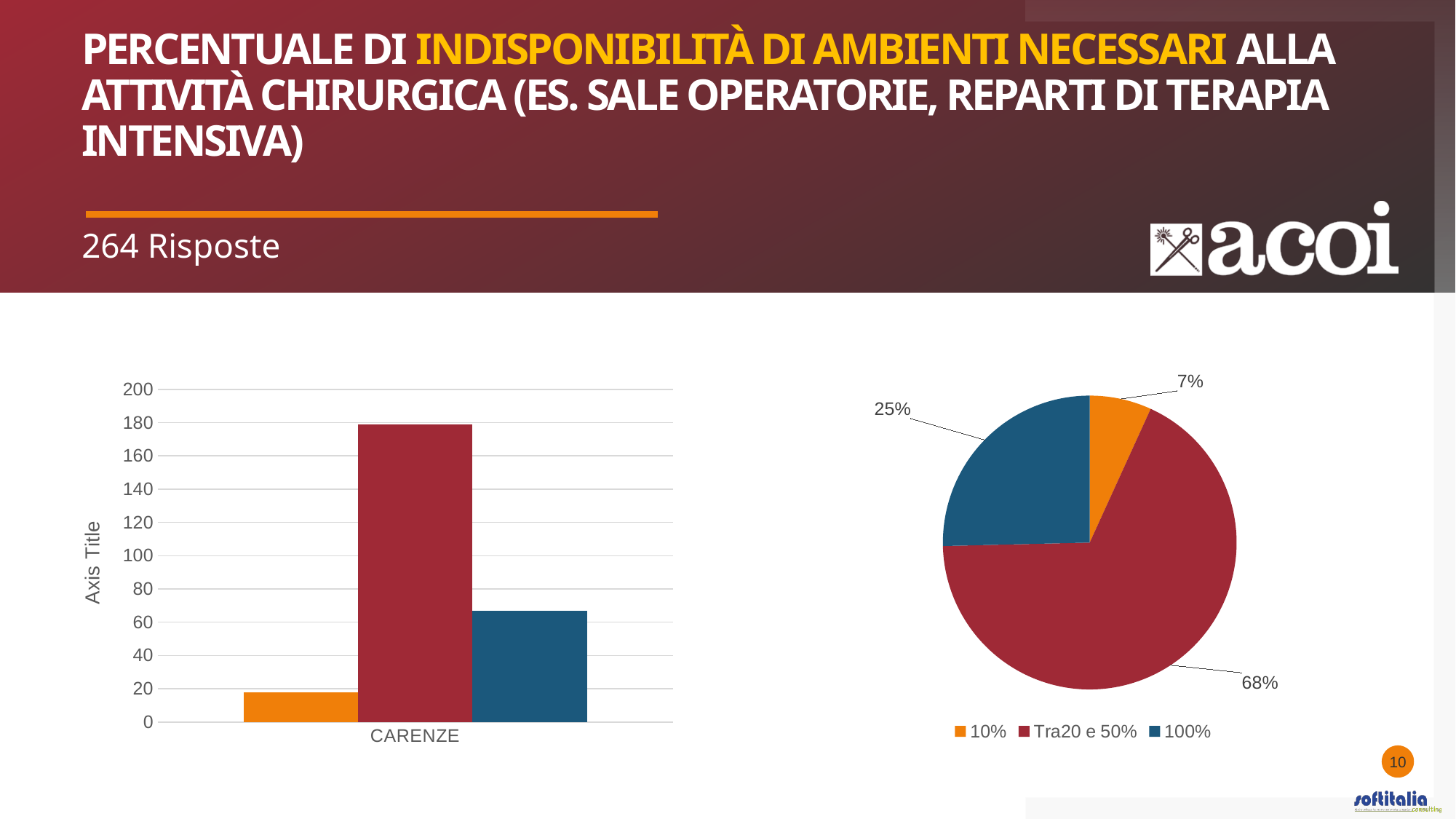
In the bar chart on the left, is the value of the orange (left) bar greater or less than 20? less In the pie chart on the right, what share is shown for the 'Tra20 e 50%' slice? 68% What kind of chart is the chart on the left of the slide? Bar chart In the bar chart on the left, what is the category label shown on the x axis? CARENZE In the pie chart on the right, what share is shown for the '100%' slice? 25% In the pie chart on the right, which legend category has the smallest slice? 10% How many entries does the legend of the pie chart on the right list? 3 In the pie chart on the right, what share is shown for the '10%' slice? 7% In the bar chart on the left, is the value of the red (middle) bar greater or less than 160? greater In the bar chart on the left, which bar is the tallest? The red (middle) bar In the pie chart on the right, which legend category has the largest slice? Tra20 e 50% In the pie chart on the right, how many percentage points larger is the 'Tra20 e 50%' slice than the '100%' slice? 43 percentage points